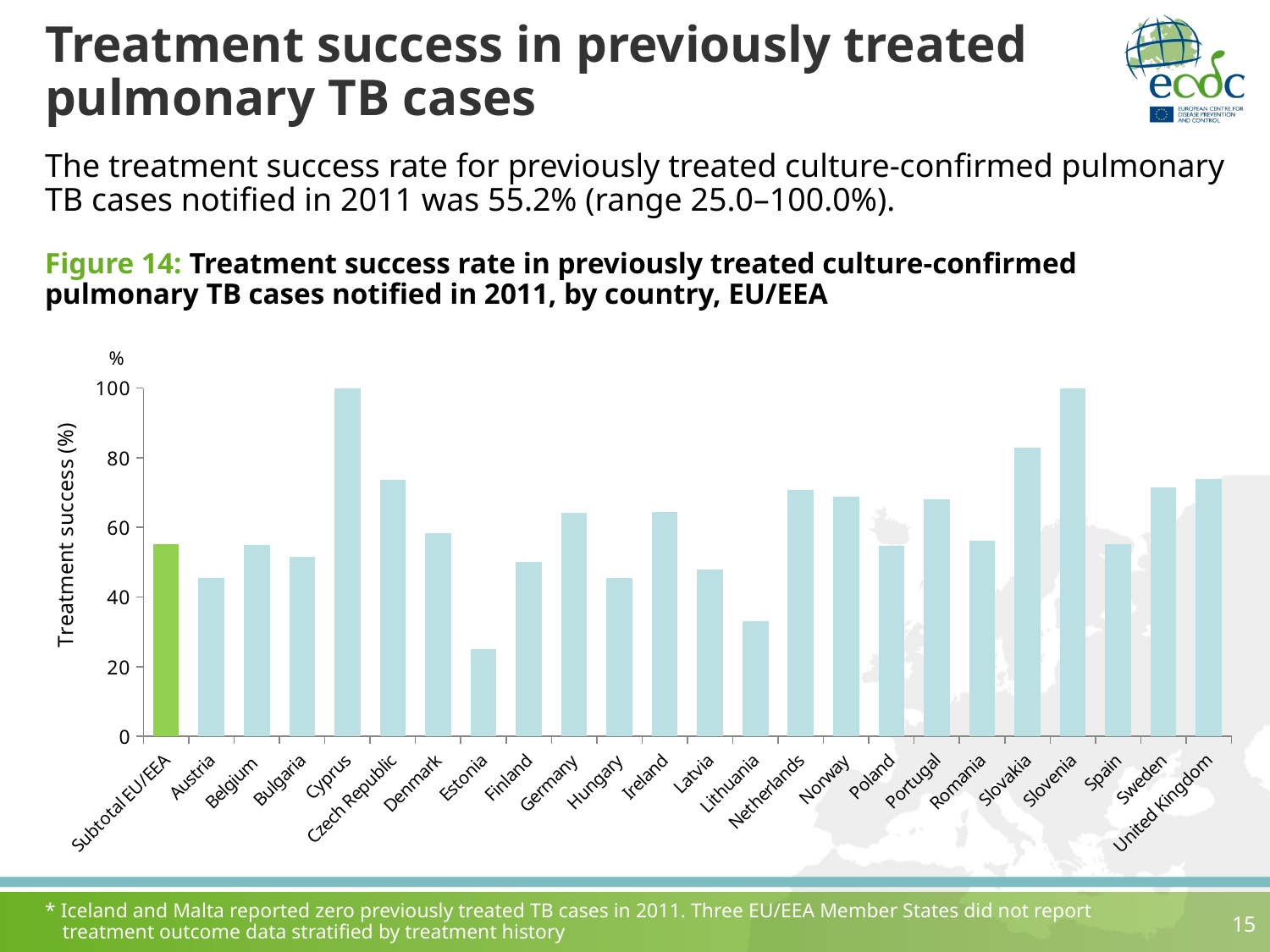
What is the treatment success rate for Slovenia? 100% Which country has the lowest treatment success rate in the chart? Estonia What kind of chart is shown in Figure 14? bar chart Is the value for Lithuania greater or less than 40? less Is the value for Slovakia greater or less than 80? greater What is the treatment success rate for Subtotal EU/EEA? 55.2% Is the value for Netherlands greater or less than 60? greater What is the treatment success rate for Cyprus? 100% Which has a higher treatment success rate, Germany or Hungary? Germany How many countries/categories are shown on the x axis of the chart? 24 Which has a higher treatment success rate, Slovakia or Sweden? Slovakia What is the label on the y axis of the chart? Treatment success (%)